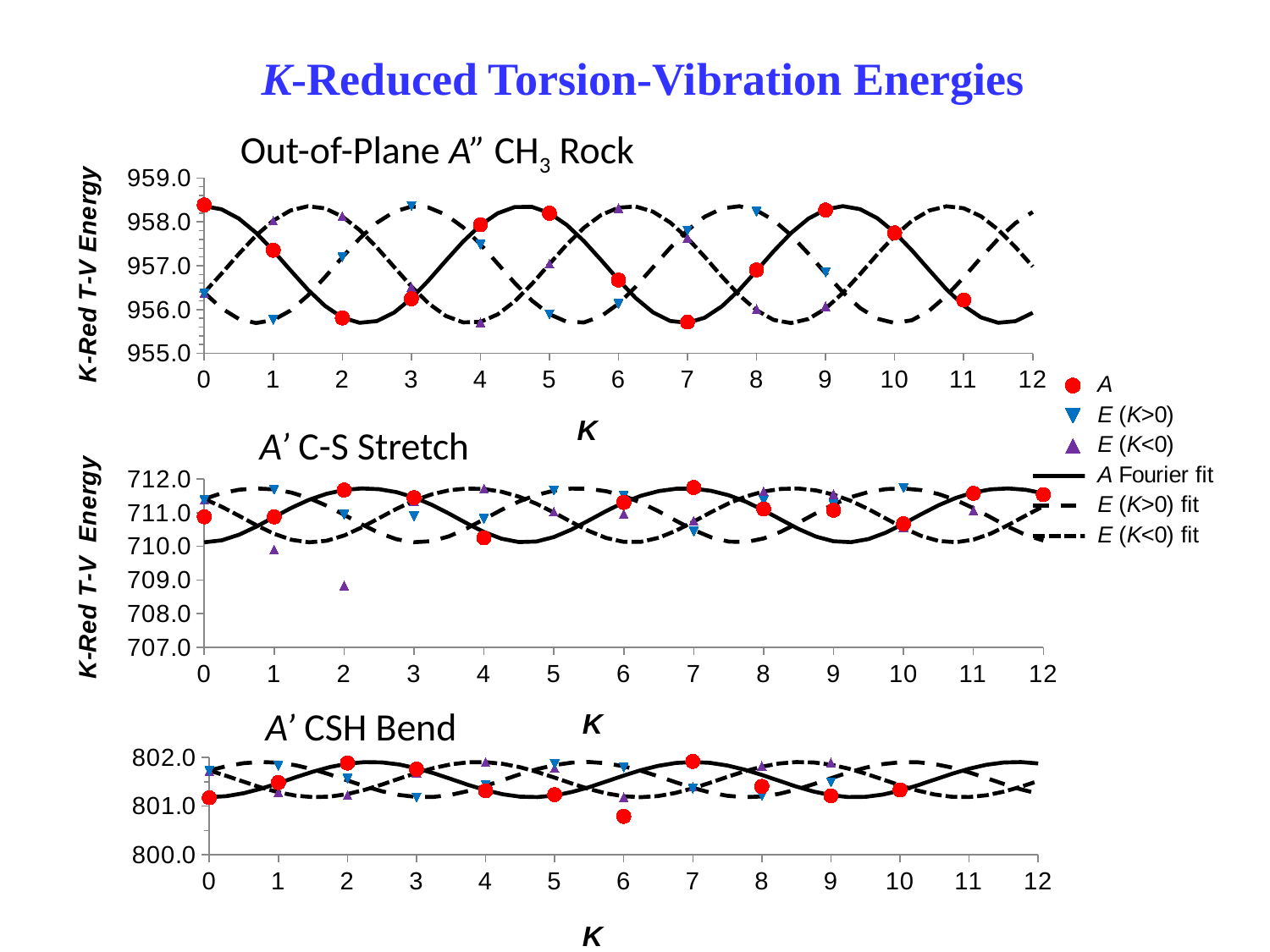
In the "A' CSH Bend" chart, at which K is the A series lowest? K = 6 How many charts are shown on the slide? 3 What is the title of the bottom chart on the slide? A' CSH Bend In the "A' C-S Stretch" chart, which is larger, the A value at K = 4 or the A value at K = 7? K = 7 In the "Out-of-Plane A'' CH3 Rock" chart, is the value of the A series at K = 7 greater or less than 956.0? less In the "Out-of-Plane A'' CH3 Rock" chart, is the value of the A series at K = 0 greater or less than 958.0? greater In the "A' C-S Stretch" chart, at which K is the E (K<0) series lowest? K = 2 In the "A' CSH Bend" chart, is the A value at K = 6 greater or less than 801.0? less What kind of chart is the "Out-of-Plane A'' CH3 Rock" chart? scatter chart How many series does the legend list? 6 In the "Out-of-Plane A'' CH3 Rock" chart, which is larger, the A value at K = 0 or the A value at K = 2? K = 0